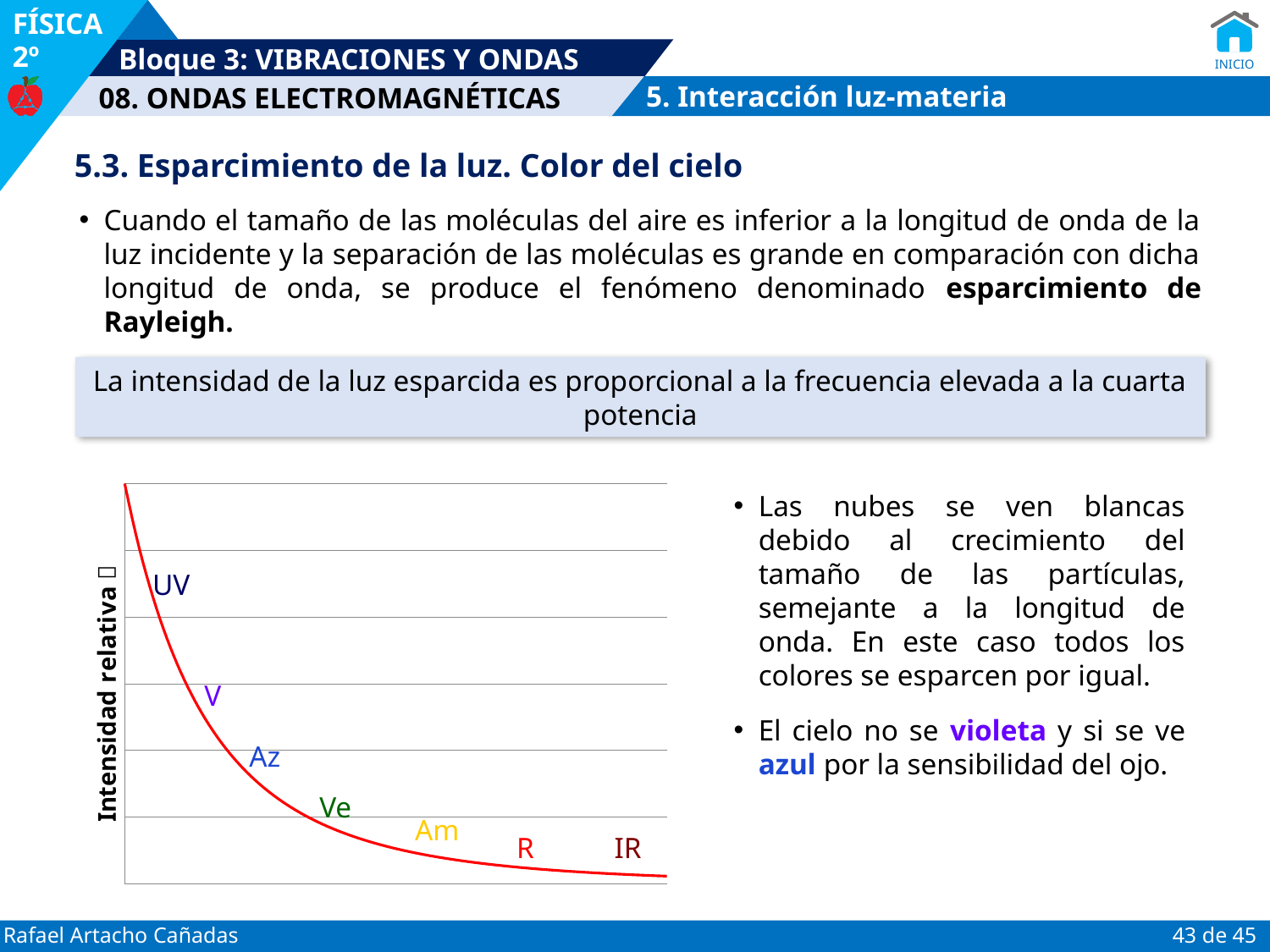
Which has a lower relative intensity on the curve, UV or Ve? Ve Which has a higher relative intensity on the curve, Az or Am? Az Which labelled point on the curve has the lowest relative intensity? IR Which labelled point appears furthest to the right on the curve? IR What colour is the plotted curve in the chart? red Does the plotted curve rise or fall as you move from left to right along the x axis? fall Which labelled point on the curve has the highest relative intensity? UV What kind of chart is shown on the slide? line chart Which has a higher relative intensity on the curve, V or R? V What is the label on the vertical axis of the chart? Intensidad relativa How many labelled points (UV, V, Az, Ve, Am, R, IR) are marked along the curve? 7